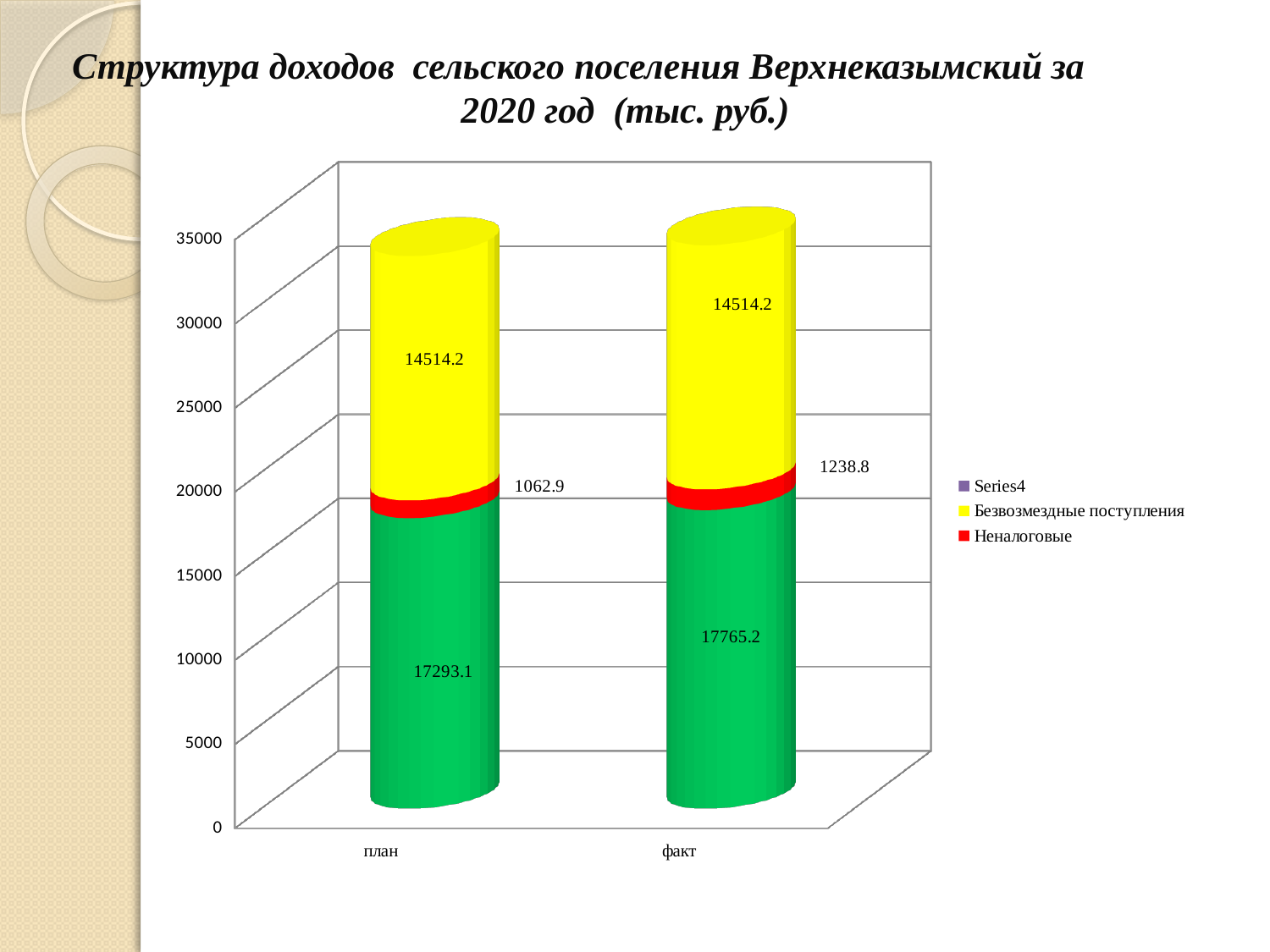
What is the value of the green segment for факт? 17765.2 What is the total of the stacked bar for факт? 33518.2 What is the value of Неналоговые for факт? 1238.8 What is the value of Неналоговые for план? 1062.9 What kind of chart is shown on the slide? Stacked bar chart What is the total of the stacked bar for план? 32870.2 What is the value of the green segment for план? 17293.1 What is the value of Безвозмездные поступления for план? 14514.2 How many categories are shown on the x axis? 2 What is the difference between the Неналоговые values for факт and план? 175.9 What is the difference between the green segment values for факт and план? 472.1 Which category has the larger Неналоговые value, план or факт? факт